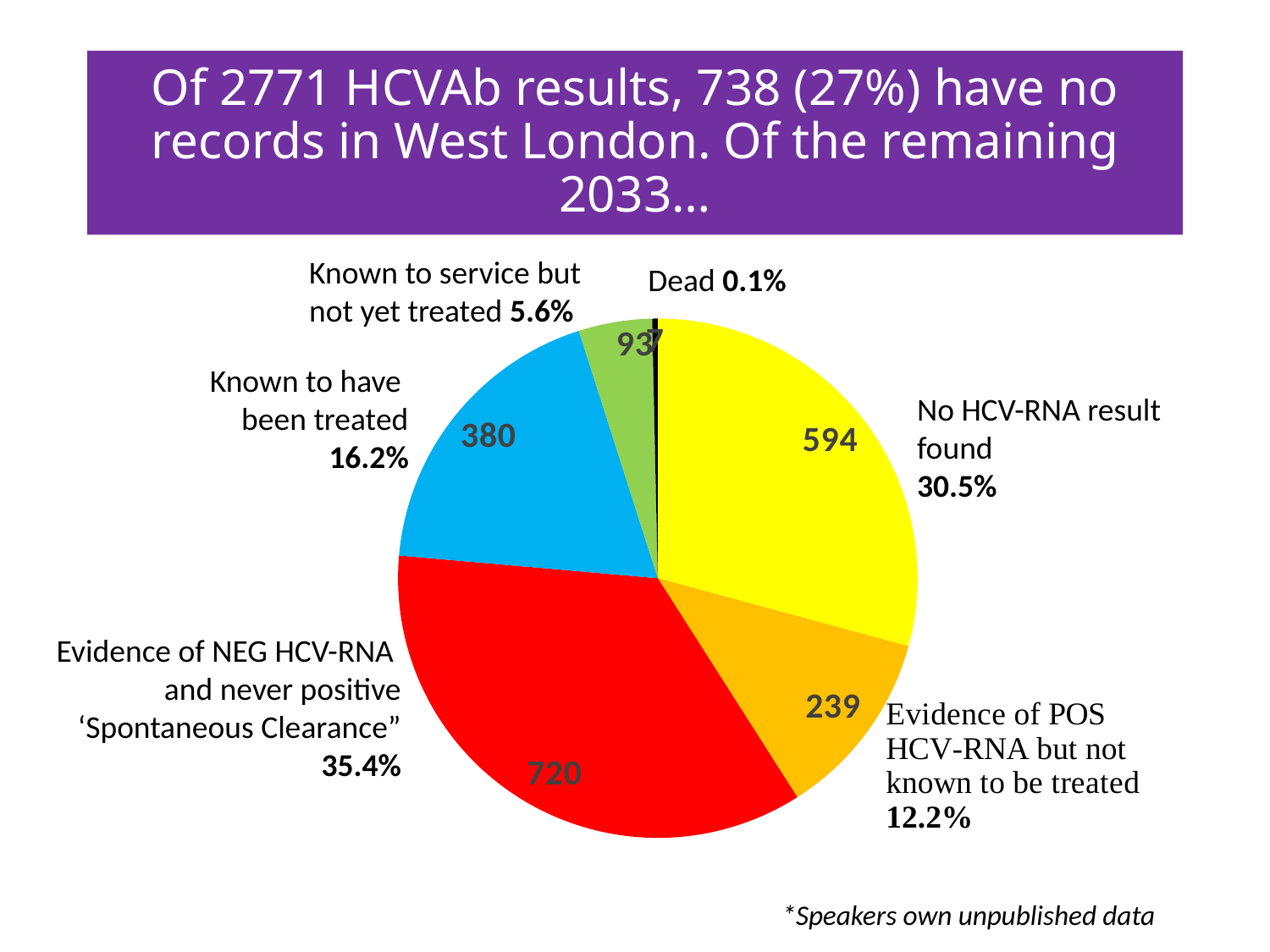
What is the difference between the 'Spontaneous Clearance' count (720) and the 'No HCV-RNA result found' count (594)? 126 Which category has the largest slice of the pie? Evidence of NEG HCV-RNA and never positive 'Spontaneous Clearance' How many slices does the pie chart have? 6 What percentage share does the 'Dead' slice represent? 0.1% How many patients had no HCV-RNA result found? 594 What is the value for the 'Evidence of NEG HCV-RNA and never positive' (Spontaneous Clearance) slice? 720 Which is larger: the number known to have been treated or the number with evidence of POS HCV-RNA but not known to be treated? Known to have been treated What is the value for 'Evidence of POS HCV-RNA but not known to be treated'? 239 What percentage share does the 'Known to service but not yet treated' slice represent? 5.6% Which category has the smallest slice of the pie? Dead How many patients are known to have been treated? 380 What kind of chart is shown on the slide? pie chart